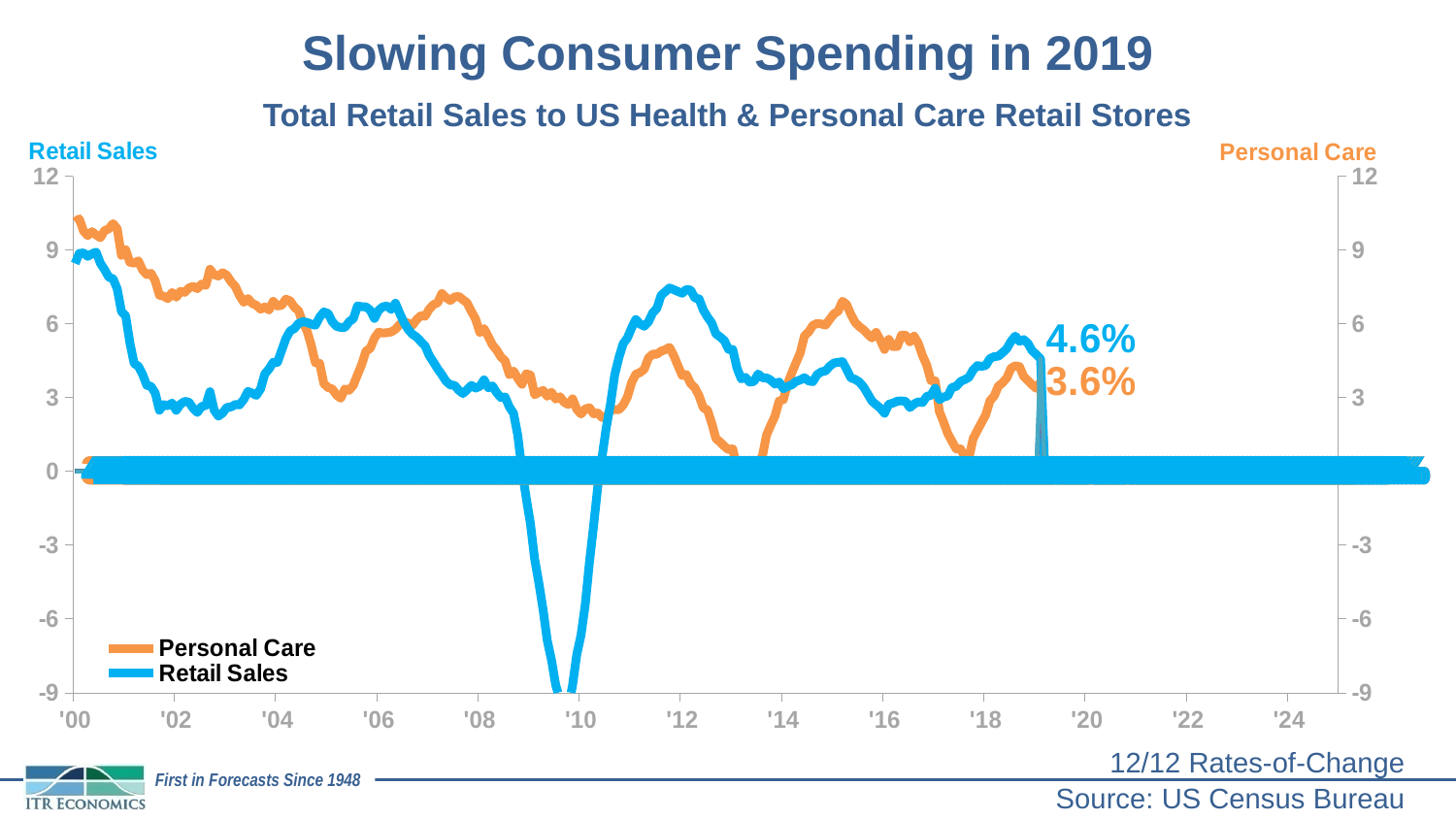
What is the difference between the labelled end values for Retail Sales (4.6%) and Personal Care (3.6%)? 1.0% What kind of chart is shown on the slide? line chart Which series reaches the lowest value on the chart? Retail Sales How many series does the legend list? 2 What is the latest labelled value for Retail Sales? 4.6% What is the title of the chart? Total Retail Sales to US Health & Personal Care Retail Stores Is the Retail Sales value around '12 greater or less than 6? greater Does the Personal Care line rise or fall between '00 and '02? fall Is the Personal Care value at '00 greater or less than 9? greater What is the latest labelled value for Personal Care? 3.6% At the end of the plotted data, which series has the higher labelled value, Retail Sales or Personal Care? Retail Sales Is the Retail Sales value around '09 greater or less than -6? less